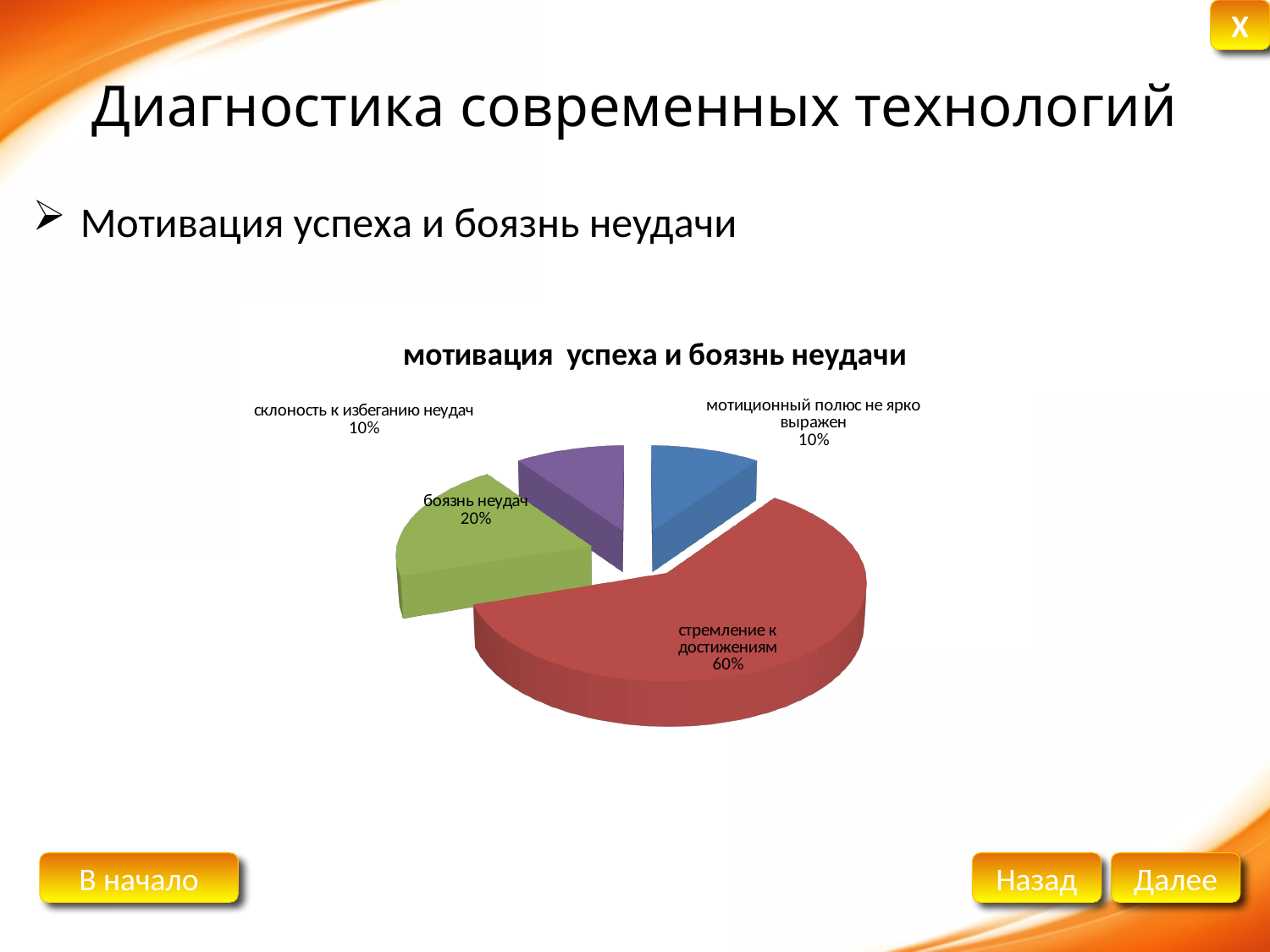
Which category has the largest slice of the pie? стремление к достижениям What share of the pie is labelled "склоность к избеганию неудач"? 10% Which is larger, the share for "боязнь неудач" or the share for "склоность к избеганию неудач"? боязнь неудач What share of the pie is labelled "мотиционный полюс не ярко выражен"? 10% How many slices does the pie chart have? 4 What share of the pie is labelled "стремление к достижениям"? 60% What is the difference between the shares for "стремление к достижениям" and "боязнь неудач"? 40% What colour is the slice for "стремление к достижениям"? red What is the combined share of "склоность к избеганию неудач" and "мотиционный полюс не ярко выражен"? 20% What is the title of the chart? мотивация успеха и боязнь неудачи What kind of chart is shown on the slide? pie chart What share of the pie is labelled "боязнь неудач"? 20%